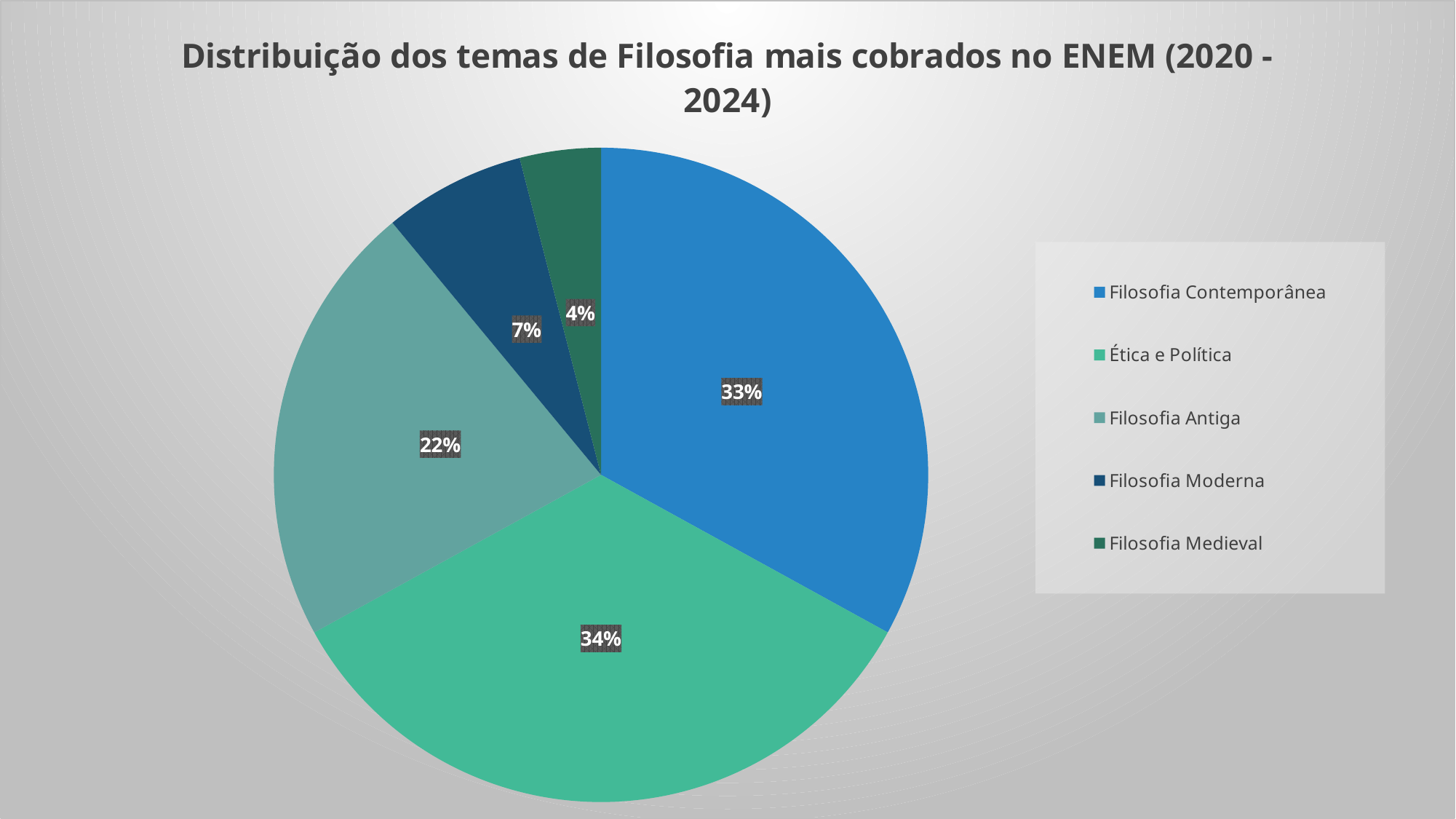
What is the difference in percentage points between Filosofia Antiga and Filosofia Moderna? 15 Which category has the largest slice of the pie? Ética e Política What is the title of the chart? Distribuição dos temas de Filosofia mais cobrados no ENEM (2020 - 2024) What share of the pie does Filosofia Moderna represent? 7% Which is larger, the share for Filosofia Antiga or the share for Filosofia Medieval? Filosofia Antiga What share of the pie does Ética e Política represent? 34% How many categories are shown in the pie chart? 5 What kind of chart is shown on the slide? Pie chart What share of the pie does Filosofia Antiga represent? 22% Which category has the smallest slice of the pie? Filosofia Medieval